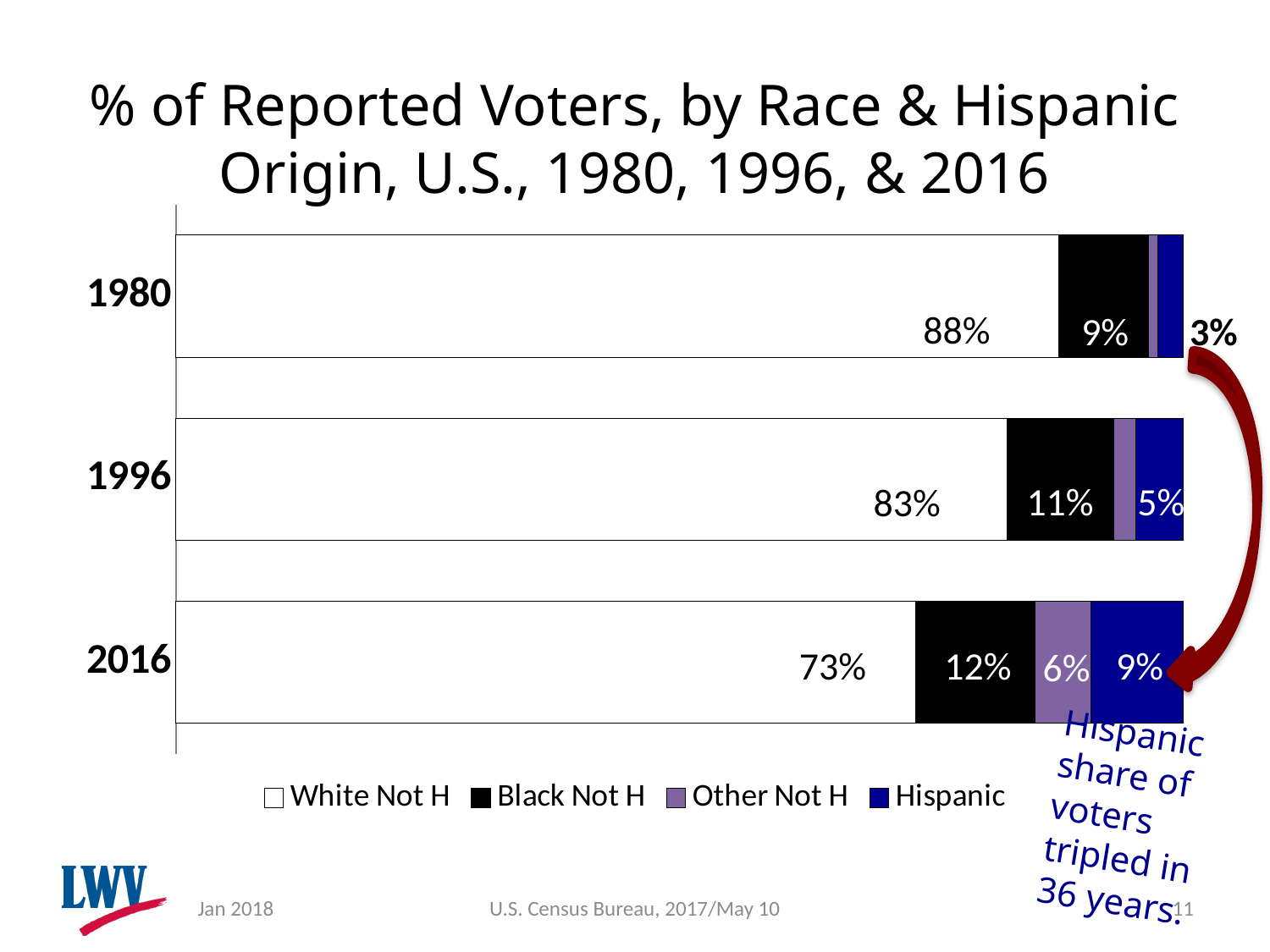
How many series does the legend list? 4 What type of chart is shown on the slide? stacked bar chart What is the Black Not H share of reported voters in 2016? 12% In which year is the Hispanic share of reported voters highest? 2016 What is the Hispanic share of reported voters in 1996? 5% Which is larger in 1996: the Black Not H share or the Hispanic share? Black Not H What is the Other Not H share of reported voters in 2016? 6% What is the White Not H share of reported voters in 1980? 88% What is the Hispanic share of reported voters in 1980? 3% How many years are shown on the chart? 3 In which year is the White Not H share of reported voters lowest? 2016 What is the difference between the White Not H share in 1980 and in 2016? 15%